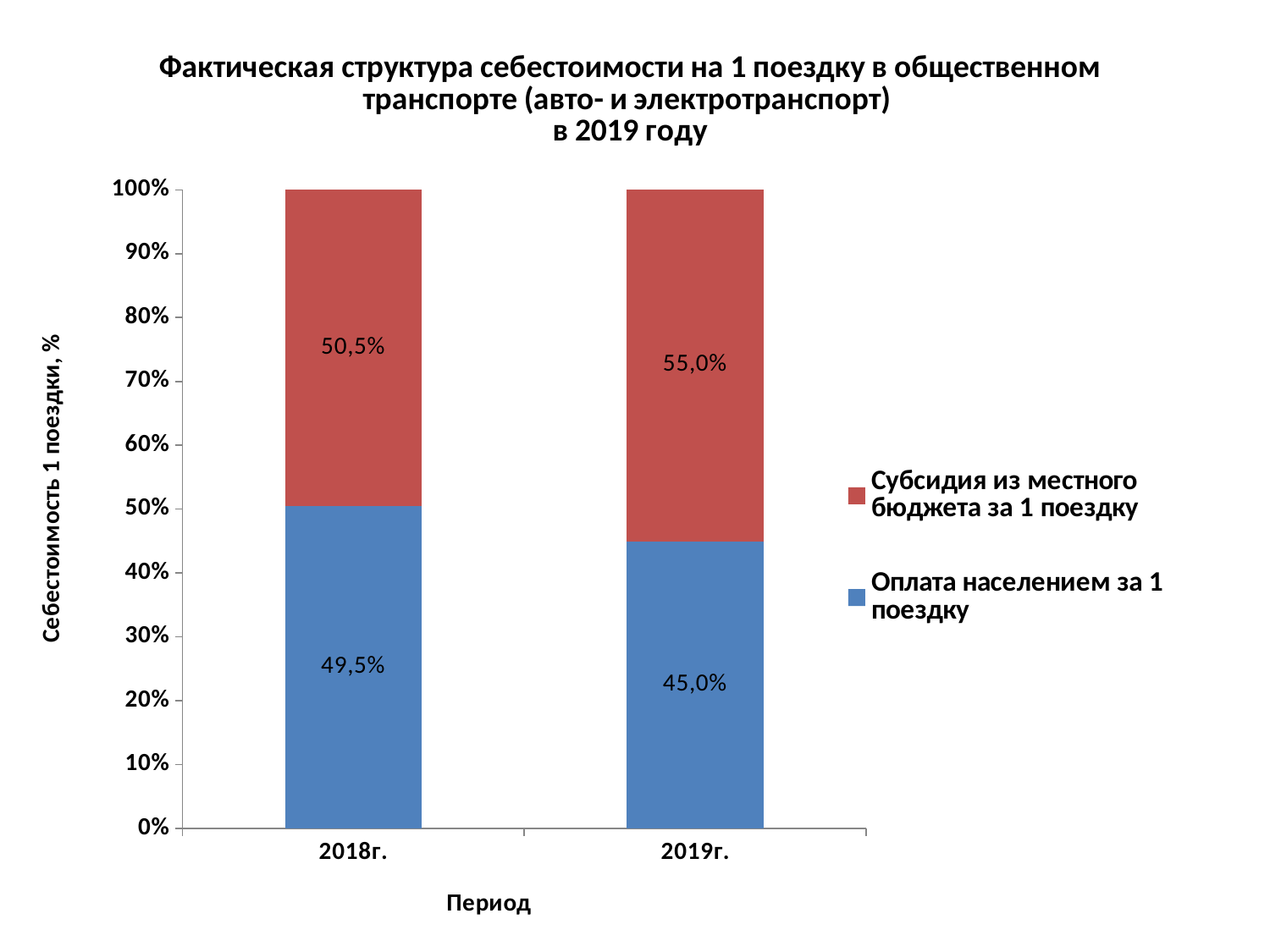
What is the value of 'Оплата населением за 1 поездку' for 2018г.? 49,5% Which is larger in 2019г.: 'Субсидия из местного бюджета за 1 поездку' or 'Оплата населением за 1 поездку'? Субсидия из местного бюджета за 1 поездку In which year is the share of 'Субсидия из местного бюджета за 1 поездку' higher? 2019г. What is the value of 'Оплата населением за 1 поездку' for 2019г.? 45,0% How many periods are shown on the x axis? 2 What is the difference between the 'Субсидия из местного бюджета за 1 поездку' values for 2019г. and 2018г.? 4,5% How many series does the legend list? 2 In which year is the share of 'Оплата населением за 1 поездку' lower? 2019г. Does the share of 'Оплата населением за 1 поездку' rise or fall from 2018г. to 2019г.? Fall What is the value of 'Субсидия из местного бюджета за 1 поездку' for 2019г.? 55,0% What is the value of 'Субсидия из местного бюджета за 1 поездку' for 2018г.? 50,5% What kind of chart is shown on the slide? Stacked bar chart